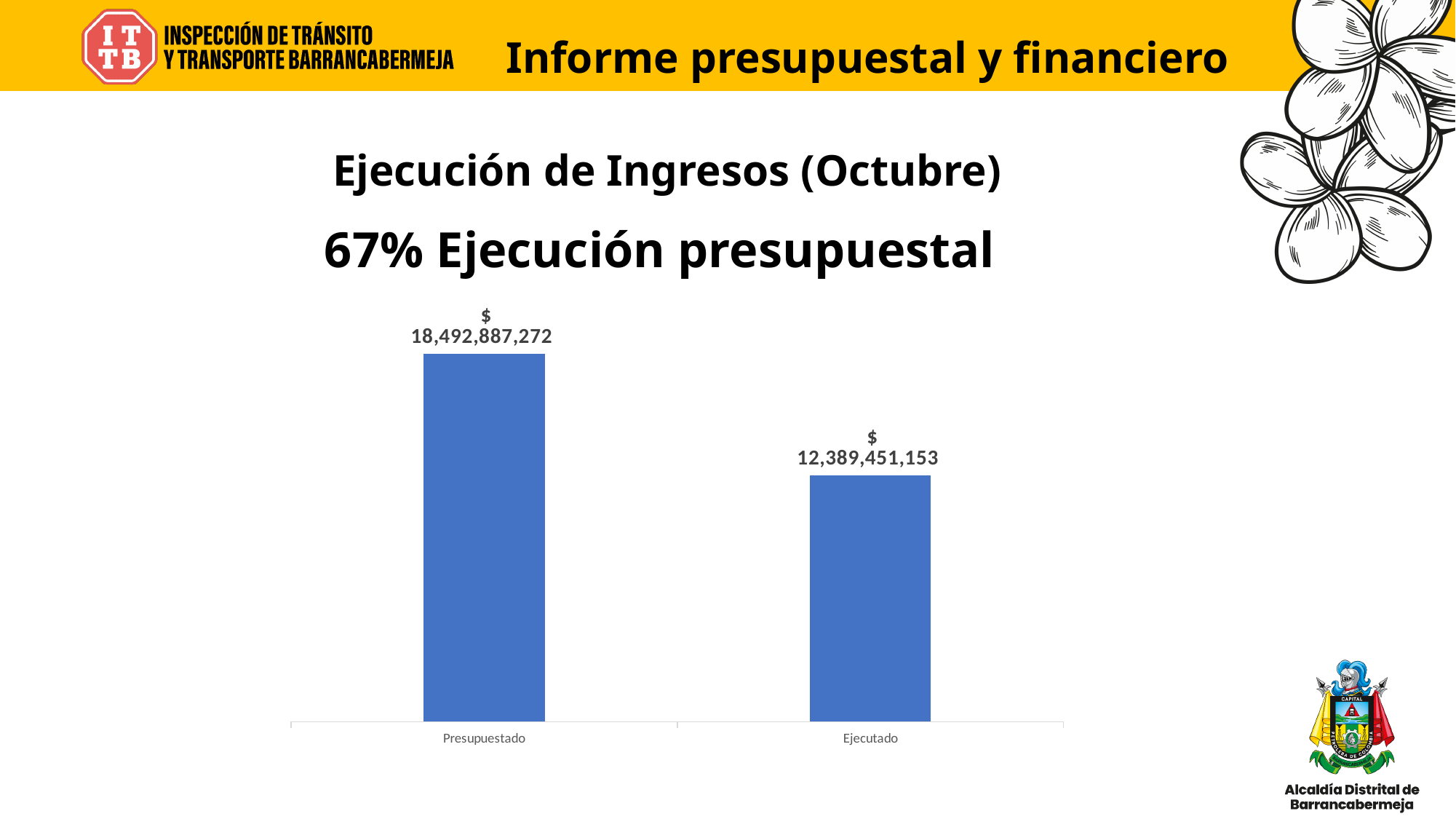
What kind of chart is shown on the slide? Bar chart Do the values rise or fall from Presupuestado to Ejecutado? Fall Which category has the lowest value? Ejecutado What is the value for Presupuestado? $ 18,492,887,272 What percentage of budget execution is stated above the chart? 67% What is the value for Ejecutado? $ 12,389,451,153 How many categories are shown in the chart? 2 What is the title of the chart? Ejecución de Ingresos (Octubre) Which category has the highest value? Presupuestado Which is larger, Presupuestado or Ejecutado? Presupuestado What is the difference between the Presupuestado and Ejecutado values? $ 6,103,436,119